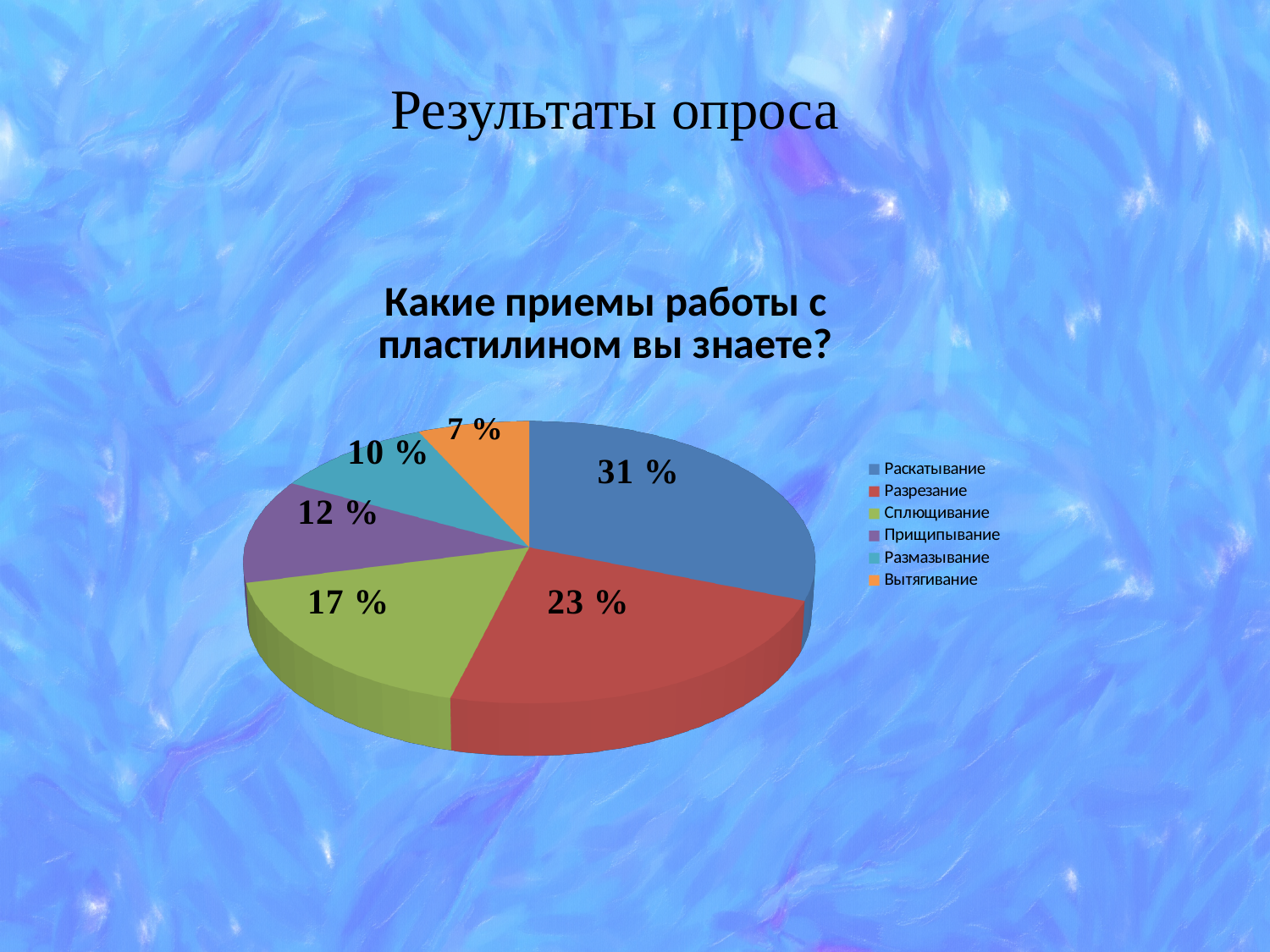
What share of the pie is Вытягивание? 7 % What kind of chart is shown on the slide? Pie chart How many slices does the pie chart have? 6 Which category has the smallest share of the pie? Вытягивание Which has a larger share, Размазывание or Прищипывание? Прищипывание What share of the pie is Раскатывание? 31 % What share of the pie is Сплющивание? 17 % What is the difference between the shares of Раскатывание and Разрезание? 8 % What is the chart's title? Какие приемы работы с пластилином вы знаете? Which category has the largest share of the pie? Раскатывание What share of the pie is Прищипывание? 12 % What share of the pie is Разрезание? 23 %